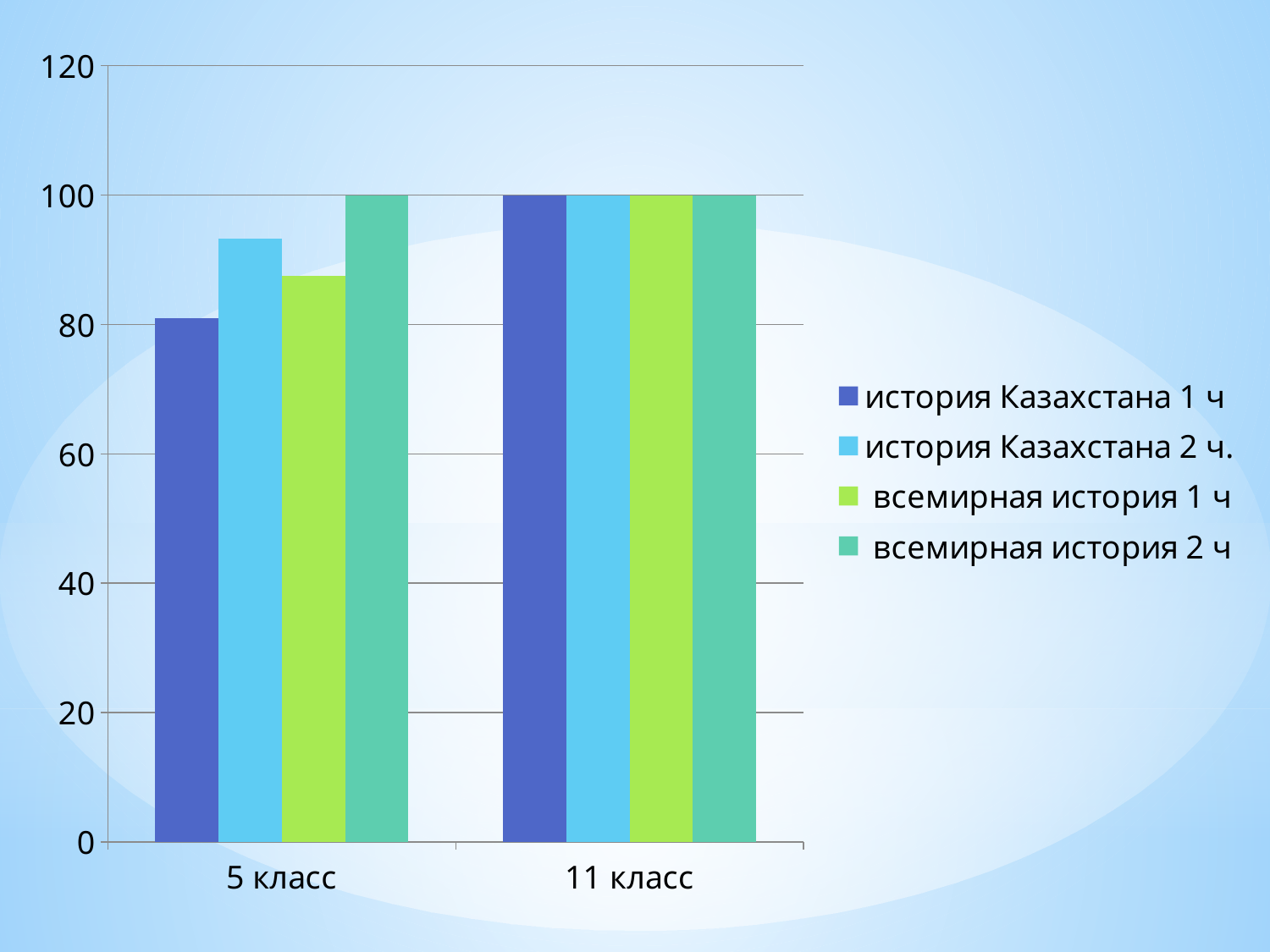
Which series has the highest value in 5 класс? всемирная история 2 ч Is the value for всемирная история 1 ч in 5 класс greater or less than 100? less What kind of chart is shown on the slide? bar chart In 5 класс, which is larger: история Казахстана 2 ч. or всемирная история 1 ч? история Казахстана 2 ч. Does the value for история Казахстана 1 ч rise or fall from 5 класс to 11 класс? rise How many categories are shown on the x axis? 2 Which series has the lowest value in 5 класс? история Казахстана 1 ч What is the value for история Казахстана 1 ч in 11 класс? 100 Is the value for история Казахстана 1 ч in 5 класс greater or less than 100? less What is the value for всемирная история 2 ч in 5 класс? 100 How many series does the legend list? 4 Is the value for история Казахстана 2 ч. in 5 класс greater or less than 80? greater